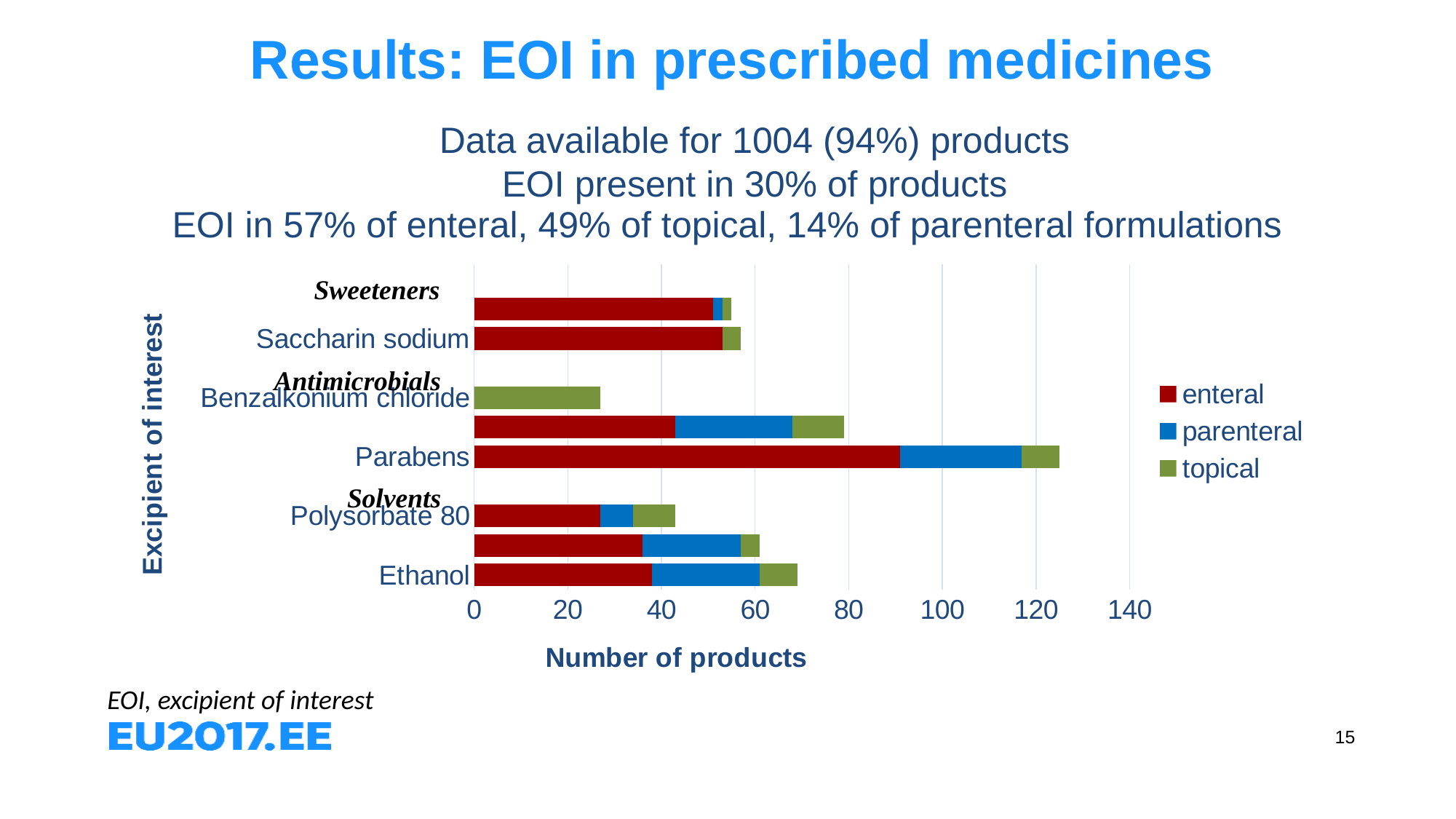
What is the title of the horizontal axis of the chart? Number of products Which excipient has the longest bar (highest total number of products)? Parabens How many series does the legend list? 3 How many bars are plotted in the chart? 8 What kind of chart is shown on the slide? bar chart Which has a larger total number of products, Benzalkonium chloride or Polysorbate 80? Polysorbate 80 Is the total value for Parabens greater or less than 120? greater Is the total value for Ethanol greater or less than 60? greater Is the total value for Polysorbate 80 greater or less than 60? less Which excipient has the shortest bar (lowest total number of products)? Benzalkonium chloride Which has a larger total number of products, Parabens or Ethanol? Parabens